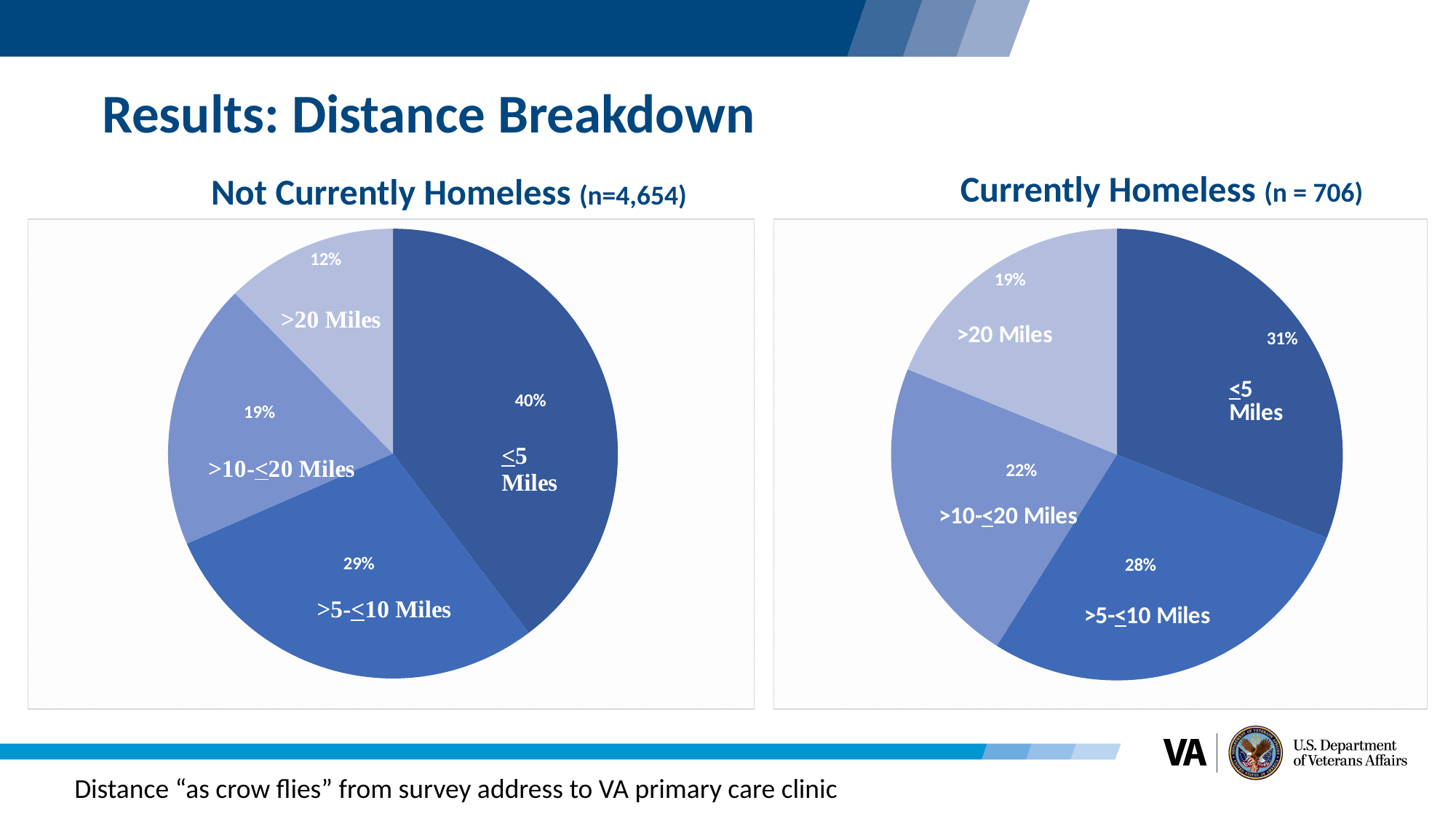
What type of chart is used for the Not Currently Homeless data? Pie chart In the Not Currently Homeless chart, which distance category has the smallest share? >20 Miles In the Not Currently Homeless chart, what is the combined share of respondents living >5-≤10 Miles and >10-≤20 Miles? 48% In the Not Currently Homeless chart, which distance category has the largest share? ≤5 Miles In the Currently Homeless chart, which distance category has the smallest share? >20 Miles Which chart has the larger share for >20 Miles, Not Currently Homeless or Currently Homeless? Currently Homeless In the Not Currently Homeless chart, what share of respondents live ≤5 miles from the clinic? 40% In the Currently Homeless chart, what share of respondents live >20 miles from the clinic? 19% What is the difference between the ≤5 Miles share in the Not Currently Homeless chart and the ≤5 Miles share in the Currently Homeless chart? 9 percentage points How many distance categories are shown in the Currently Homeless pie chart? 4 In the Currently Homeless chart, what share of respondents live >10-≤20 miles from the clinic? 22% What is the sample size shown in the title of the Currently Homeless chart? 706